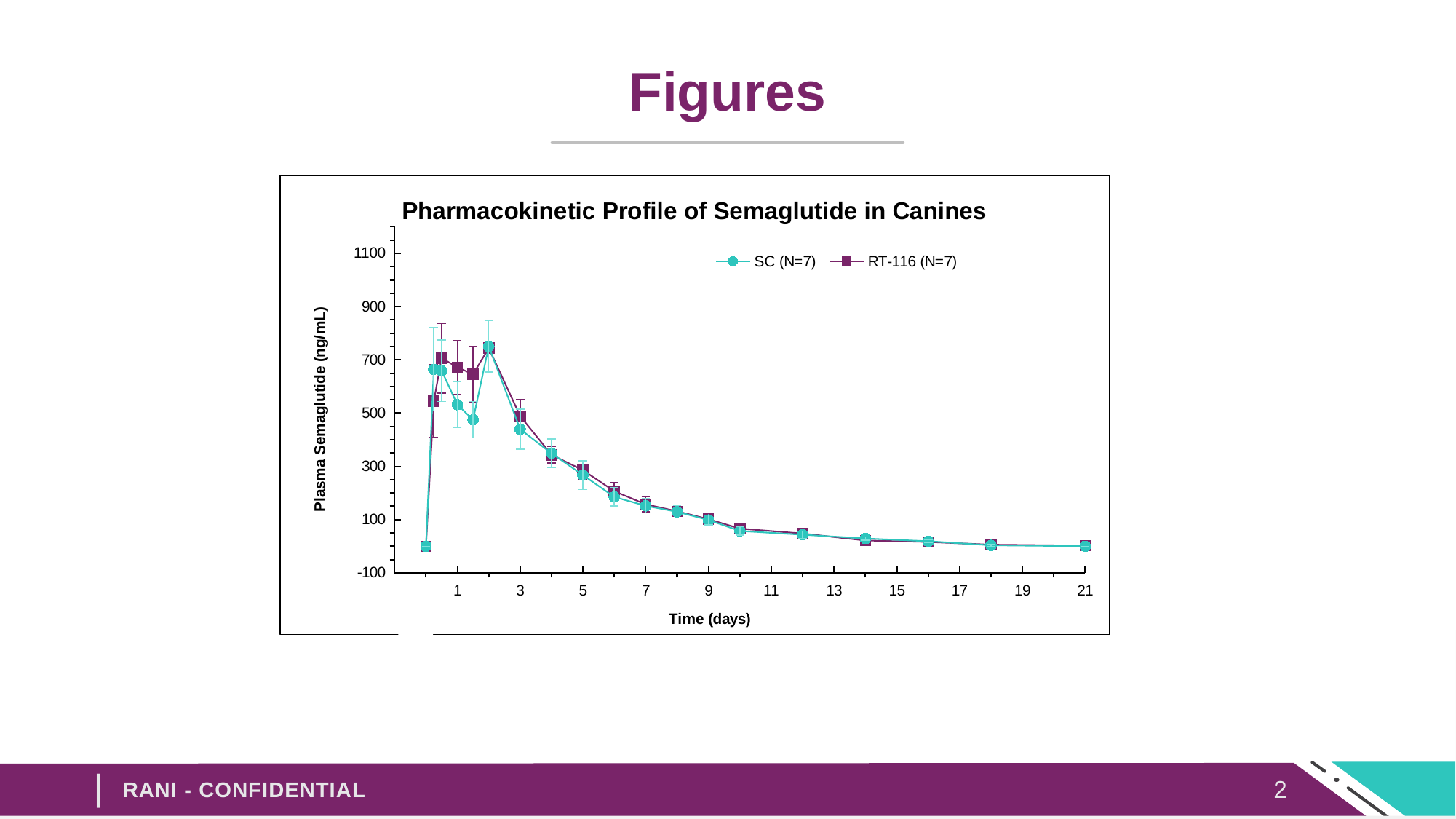
What is the title of the chart? Pharmacokinetic Profile of Semaglutide in Canines Is the value for RT-116 (N=7) at day 1 greater or less than 500? greater Is the value for RT-116 (N=7) at day 7 greater or less than 100? greater How many series does the legend list? 2 At day 1, which series has the higher value, SC (N=7) or RT-116 (N=7)? RT-116 (N=7) Is the value for SC (N=7) at day 21 greater or less than 100? less What kind of chart is shown on the slide? Line chart At which time point does the SC (N=7) series reach its highest value? Day 2 What is the label of the y axis? Plasma Semaglutide (ng/mL) After day 2, do the values for both series rise or fall as time increases? Fall